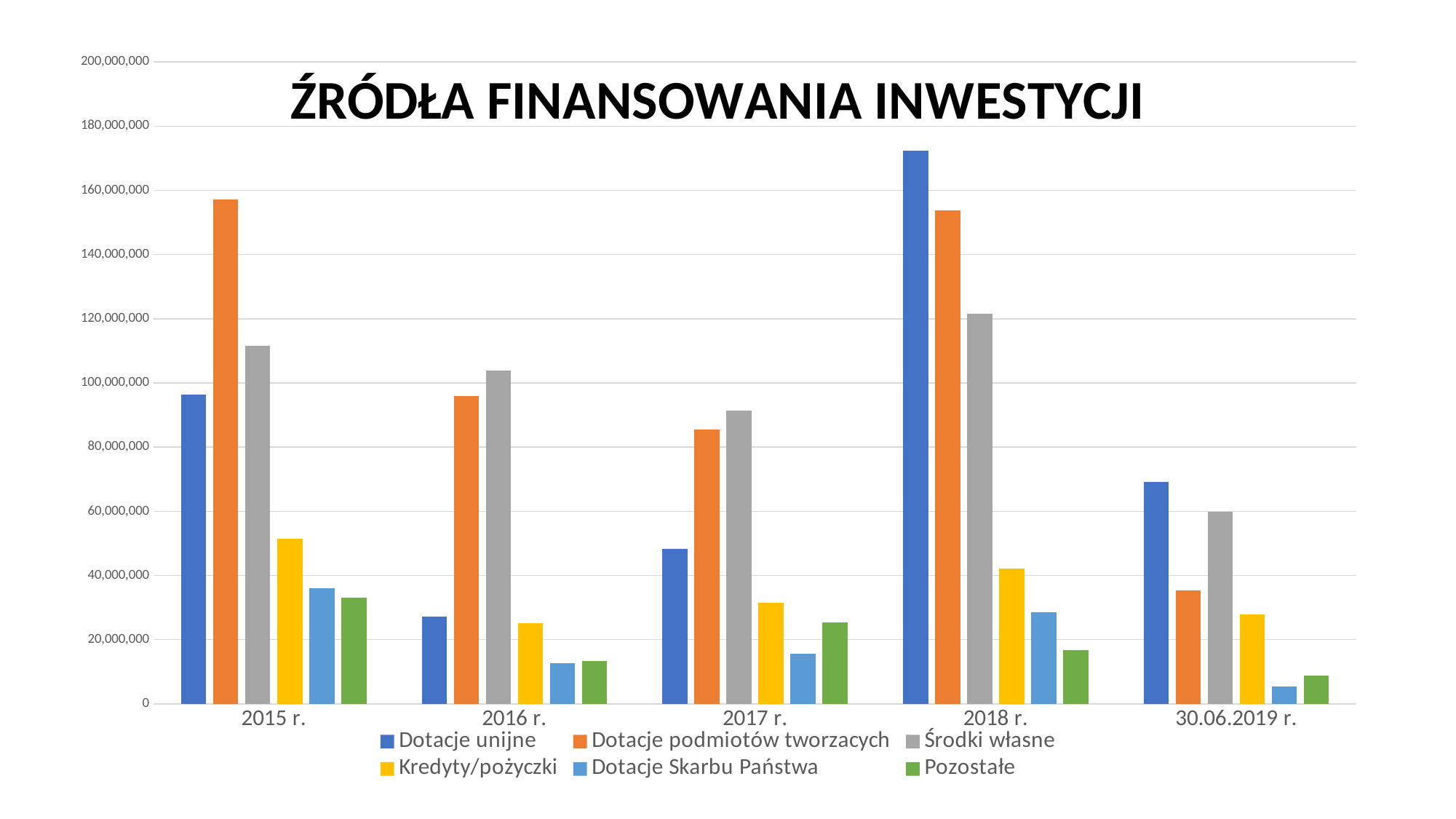
In 2018 r., which is larger: Dotacje unijne or Dotacje podmiotów tworzacych? Dotacje unijne In which period is the value for Dotacje unijne the highest? 2018 r. Is the value for Dotacje podmiotów tworzacych in 2015 r. greater or less than 140,000,000? greater Is the value for Dotacje unijne in 2018 r. greater or less than 160,000,000? greater How many categories (periods) are shown on the x axis? 5 Is the value for Środki własne in 2017 r. greater or less than 100,000,000? less In 2016 r., which is larger: Dotacje unijne or Środki własne? Środki własne What is the title of the chart? ŹRÓDŁA FINANSOWANIA INWESTYCJI Does the value for Dotacje podmiotów tworzacych rise or fall from 2015 r. to 2017 r.? fall What kind of chart is shown on the slide? bar chart In which period is the value for Dotacje Skarbu Państwa the lowest? 30.06.2019 r. How many series does the legend list? 6